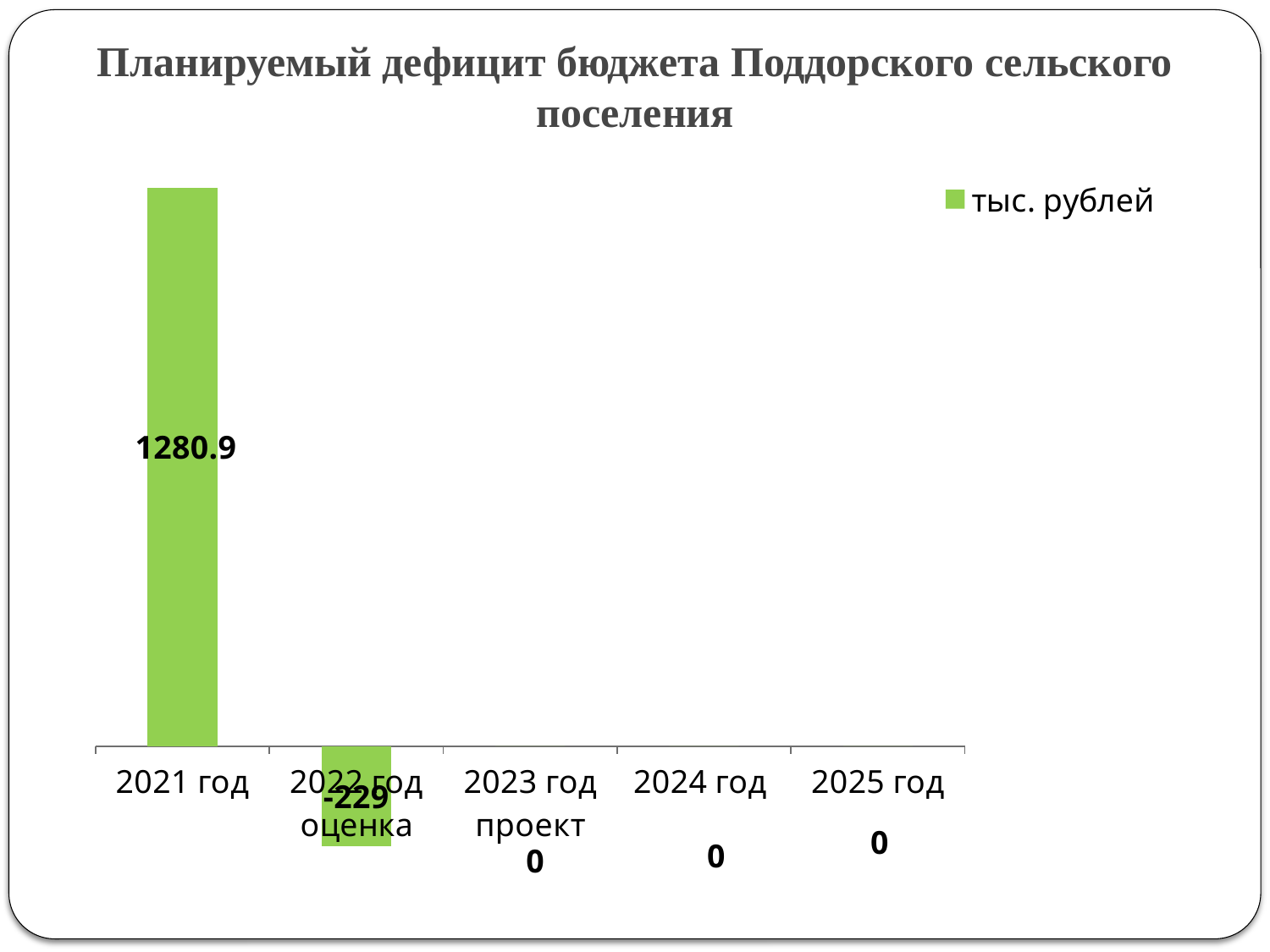
How many categories are shown on the x axis? 5 Which category has the lowest value? 2022 год оценка What kind of chart is shown on the slide? bar chart Which is larger, the value for 2021 год or the value for 2024 год? 2021 год How many series does the legend list? 1 What is the value for 2025 год? 0 What is the value for 2021 год? 1280.9 Which category has the highest value? 2021 год What is the legend entry of the chart? тыс. рублей What is the value for 2022 год оценка? -229 What is the value for 2023 год проект? 0 What is the difference between the values for 2021 год and 2022 год оценка? 1509.9